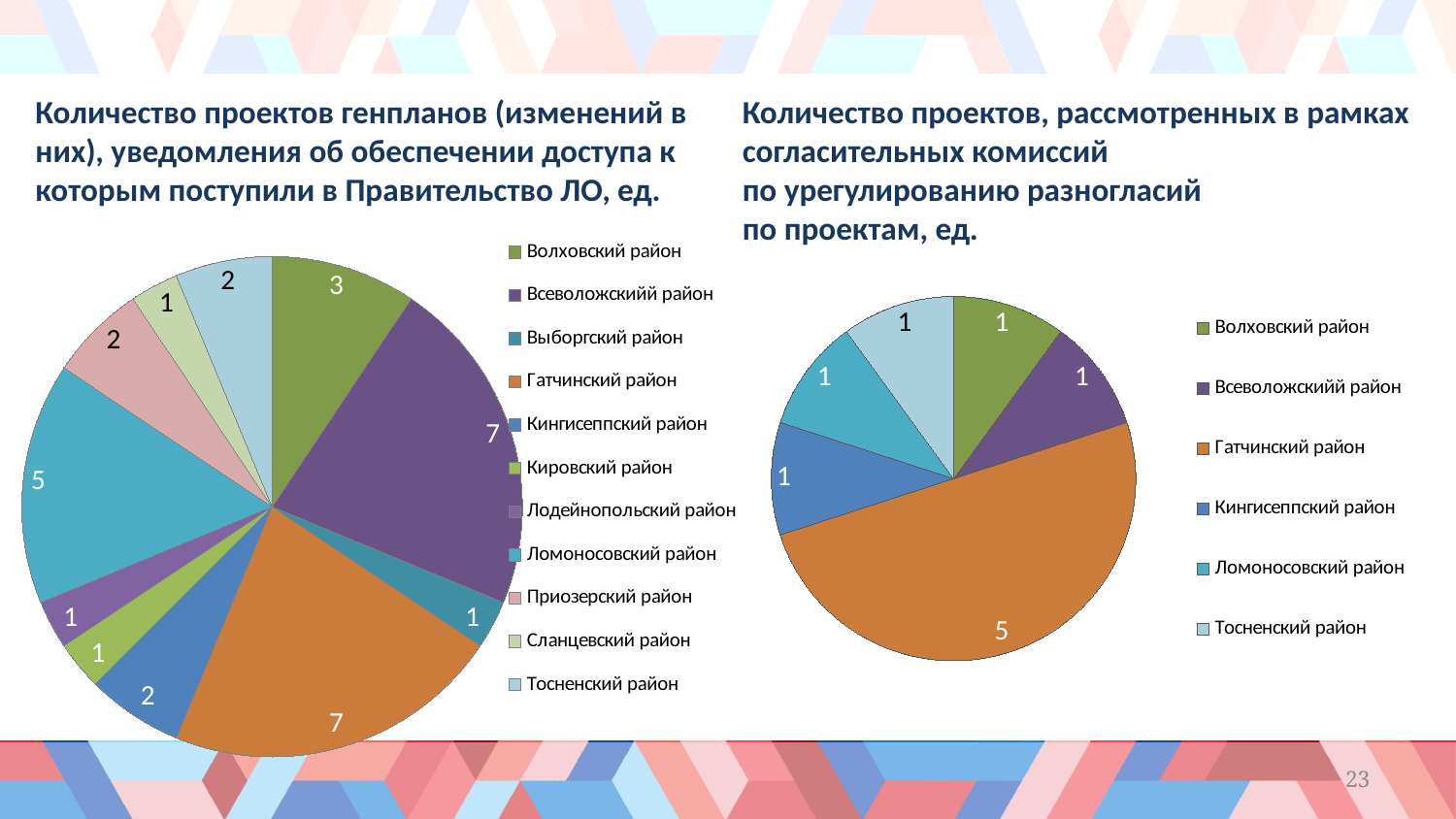
In the right pie chart (Количество проектов, рассмотренных в рамках согласительных комиссий), what share of the total does Гатчинский район represent? 50% In the left pie chart (Количество проектов генпланов), what is the difference between the values for Ломоносовский район and Волховский район? 2 In the left pie chart (Количество проектов генпланов), which is larger: the value for Кингисеппский район or the value for Ломоносовский район? Ломоносовский район In the right pie chart (Количество проектов, рассмотренных в рамках согласительных комиссий), what is the value for Гатчинский район? 5 What type of chart is used on the left side of the slide? Pie chart How many districts are listed in the legend of the left pie chart (Количество проектов генпланов)? 11 In the left pie chart (Количество проектов генпланов), what is the total of all slices? 32 How many districts are listed in the legend of the right pie chart (Количество проектов, рассмотренных в рамках согласительных комиссий)? 6 In the left pie chart (Количество проектов генпланов), what is the value for Ломоносовский район? 5 In the right pie chart (Количество проектов, рассмотренных в рамках согласительных комиссий), what colour is the slice for Гатчинский район? Orange In the left pie chart (Количество проектов генпланов), what is the value for Волховский район? 3 In the right pie chart (Количество проектов, рассмотренных в рамках согласительных комиссий), which district has the largest slice? Гатчинский район